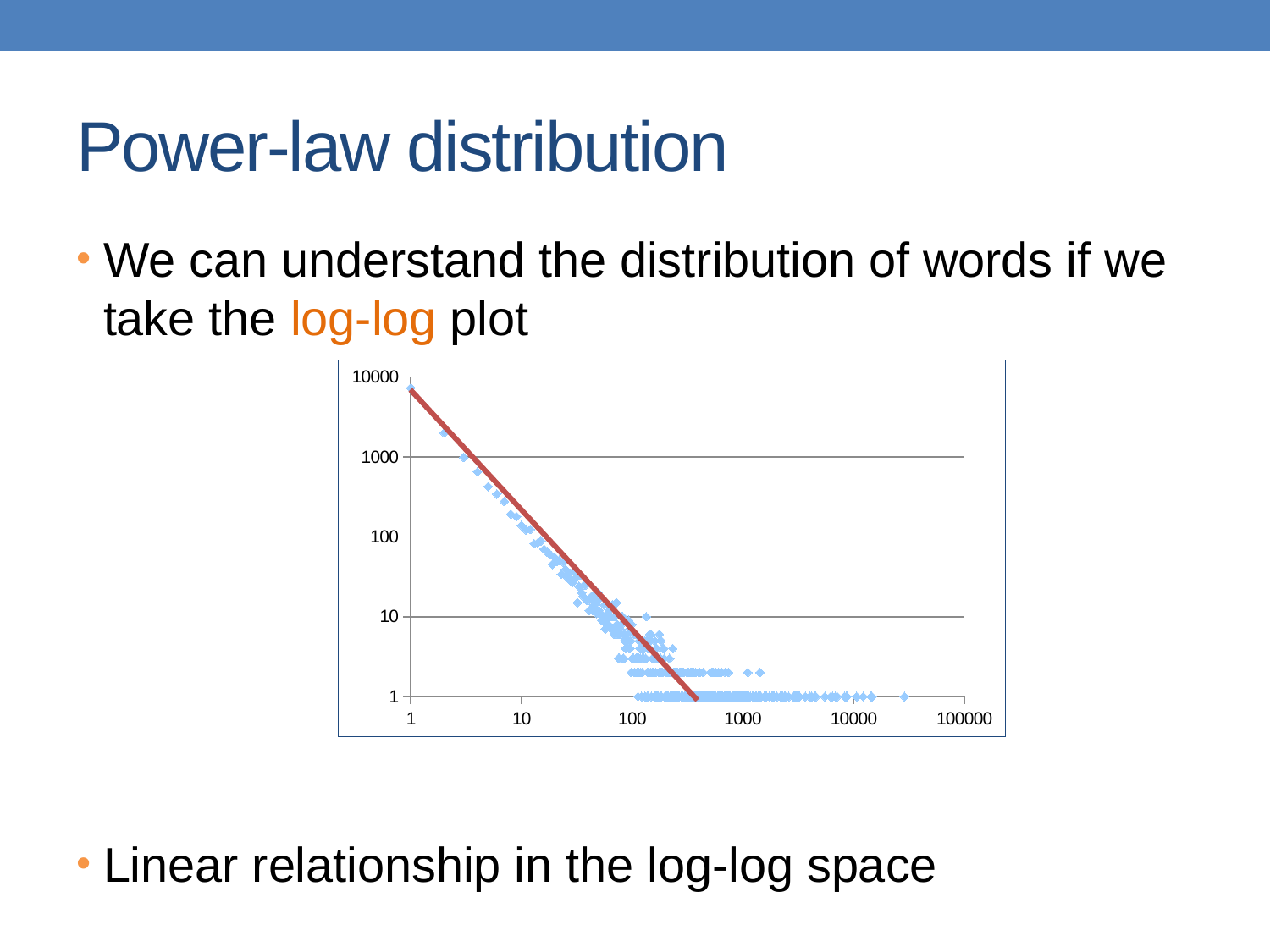
What is the lowest value shown on the y-axis? 1 How many tick labels are shown on the x-axis? 6 How many tick labels are shown on the y-axis? 5 Is the value of the plotted point at x = 10 greater or less than 100? greater What is the largest tick label shown on the y-axis? 10000 What is the largest tick label shown on the x-axis? 100000 Is the value of the highest plotted point (at x = 1) greater or less than 1000? greater What kind of chart is shown on the slide? scatter plot Is the value of the plotted points at x = 10000 greater or less than 10? less Do the plotted values rise or fall as the x-axis value increases? fall